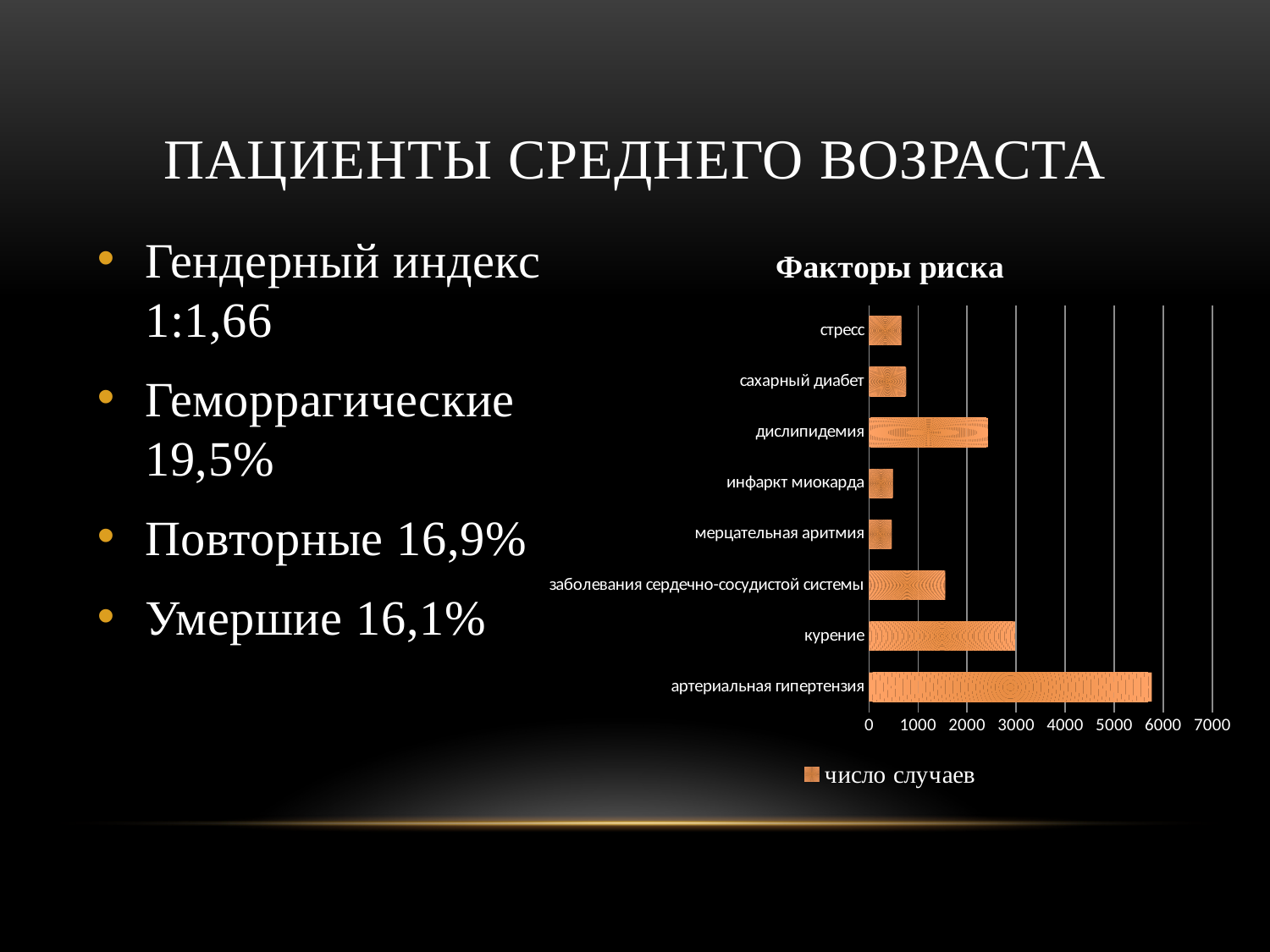
Which risk factor has the highest number of cases? артериальная гипертензия Is the value for дислипидемия greater or less than 2000? greater How many risk factor categories are plotted in the chart? 8 Which has more cases: артериальная гипертензия or курение? артериальная гипертензия What is the name of the series shown in the legend? число случаев Is the value for заболевания сердечно-сосудистой системы greater or less than 1000? greater Is the value for артериальная гипертензия greater or less than 5000? greater What is the title of the chart? Факторы риска Which has more cases: дислипидемия or заболевания сердечно-сосудистой системы? дислипидемия What kind of chart is shown on the slide? bar chart How many series does the chart legend list? 1